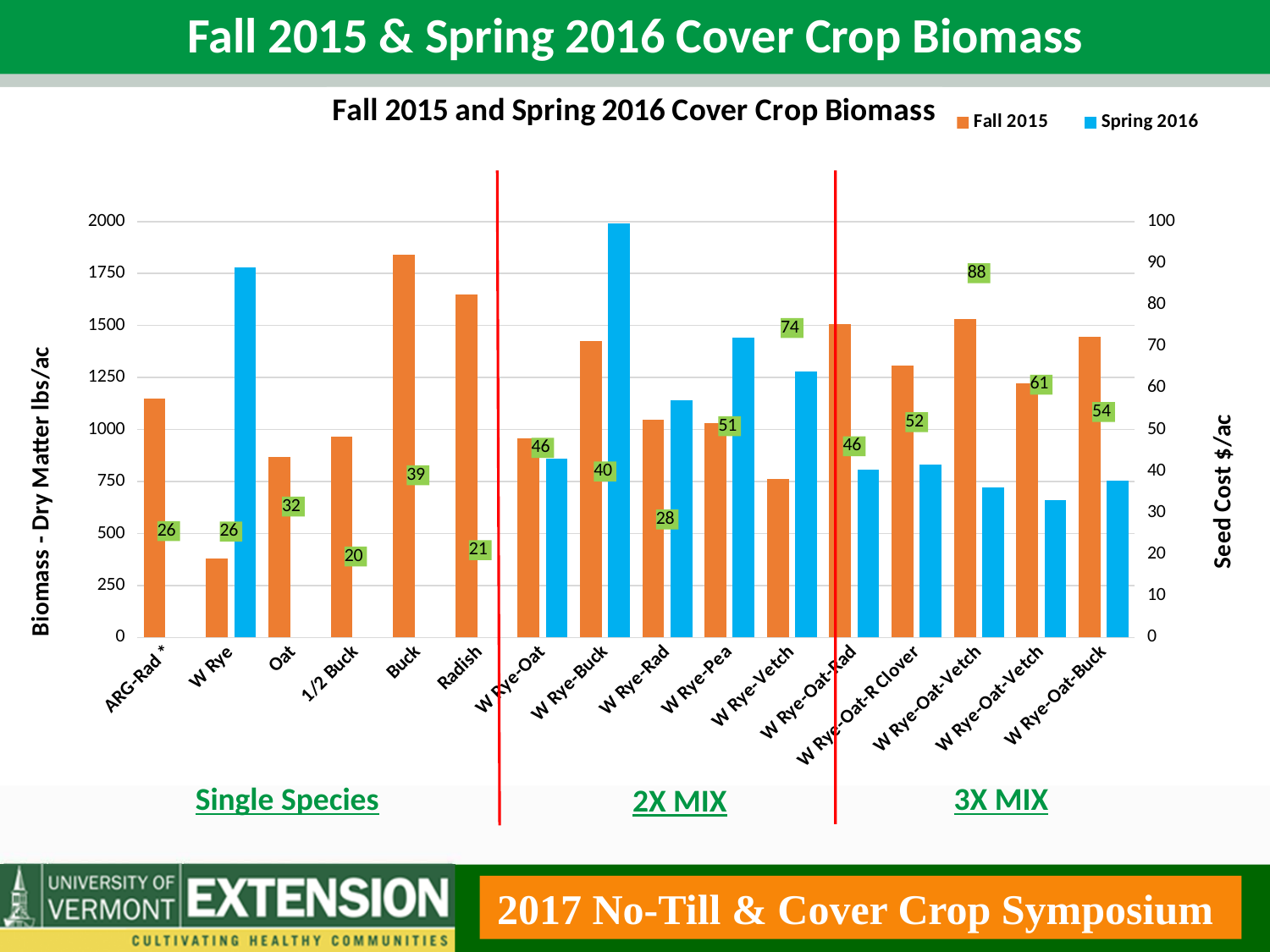
How many cover crop categories are shown along the x axis? 16 Which has the larger Spring 2016 biomass, W Rye-Buck or W Rye-Pea? W Rye-Buck What is the seed cost ($/ac) labelled for 1/2 Buck? 20 Which category has the lowest labelled seed cost? 1/2 Buck Which category has the highest Fall 2015 biomass? Buck What is the highest seed cost value labelled on the chart? 88 What is the seed cost ($/ac) labelled for W Rye-Vetch? 74 How many series does the chart legend list? 2 Is the Fall 2015 biomass for W Rye greater or less than 500 lbs/ac? less What kind of chart is shown on the slide? bar chart What is the difference in seed cost between W Rye-Vetch and W Rye-Rad? 46 What is the seed cost ($/ac) labelled for W Rye-Oat-R Clover? 52